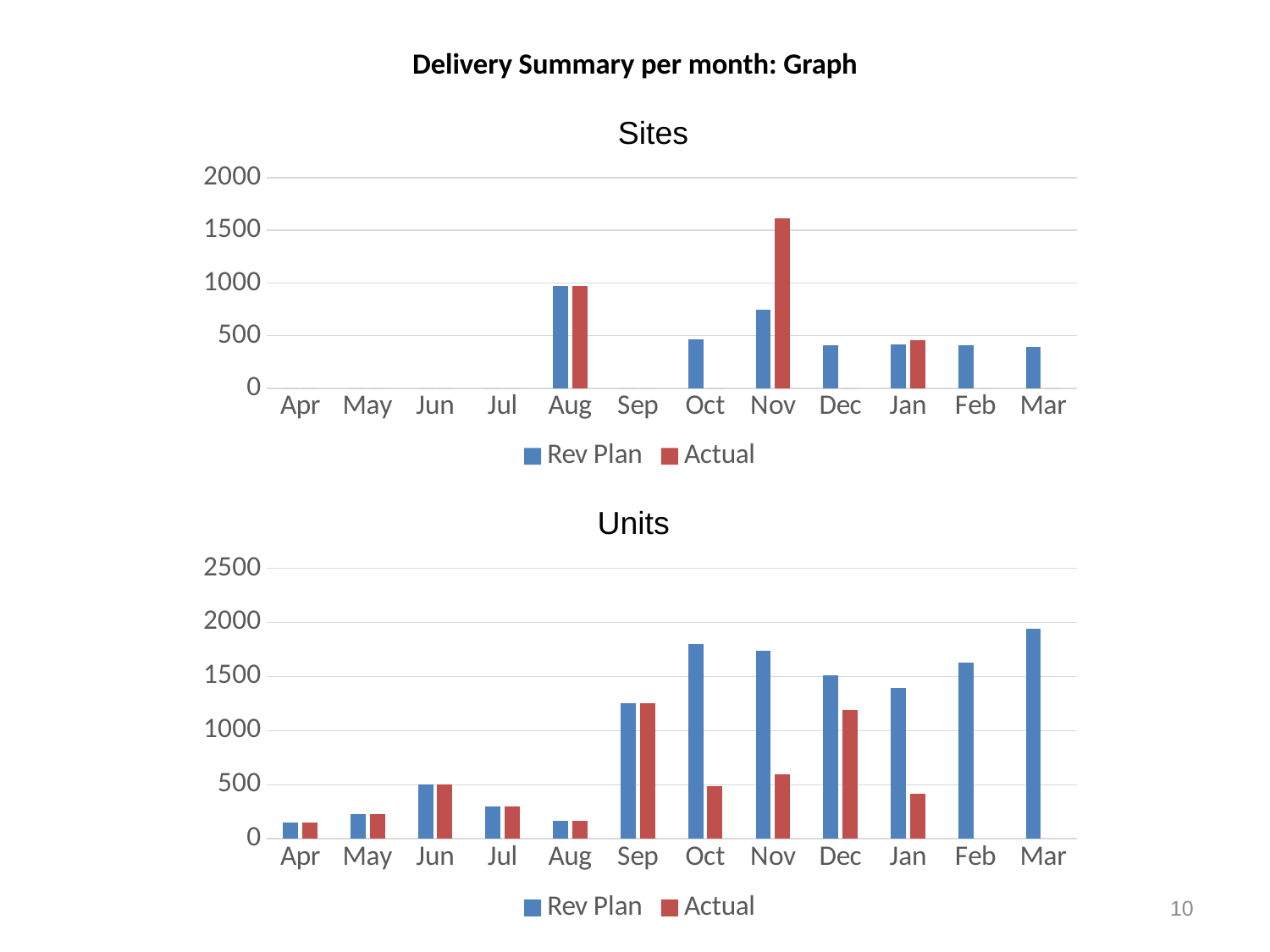
In the "Sites" chart, is the Rev Plan value for Aug greater or less than 500? greater In the "Sites" chart, for Nov, which is larger: Rev Plan or Actual? Actual In the "Sites" chart, is the Actual value for Nov greater or less than 1500? greater What are the two legend entries in the "Units" chart? Rev Plan and Actual In the "Units" chart, is the Rev Plan value for Oct greater or less than 1500? greater In the "Units" chart, which month has the highest Rev Plan value? Mar In the "Units" chart, for Dec, which is larger: Rev Plan or Actual? Rev Plan How many series does the legend of the "Sites" chart list? 2 In the "Sites" chart, which month has the highest Actual value? Nov What kind of chart is the "Sites" chart? bar chart How many months are shown on the x axis of the "Units" chart? 12